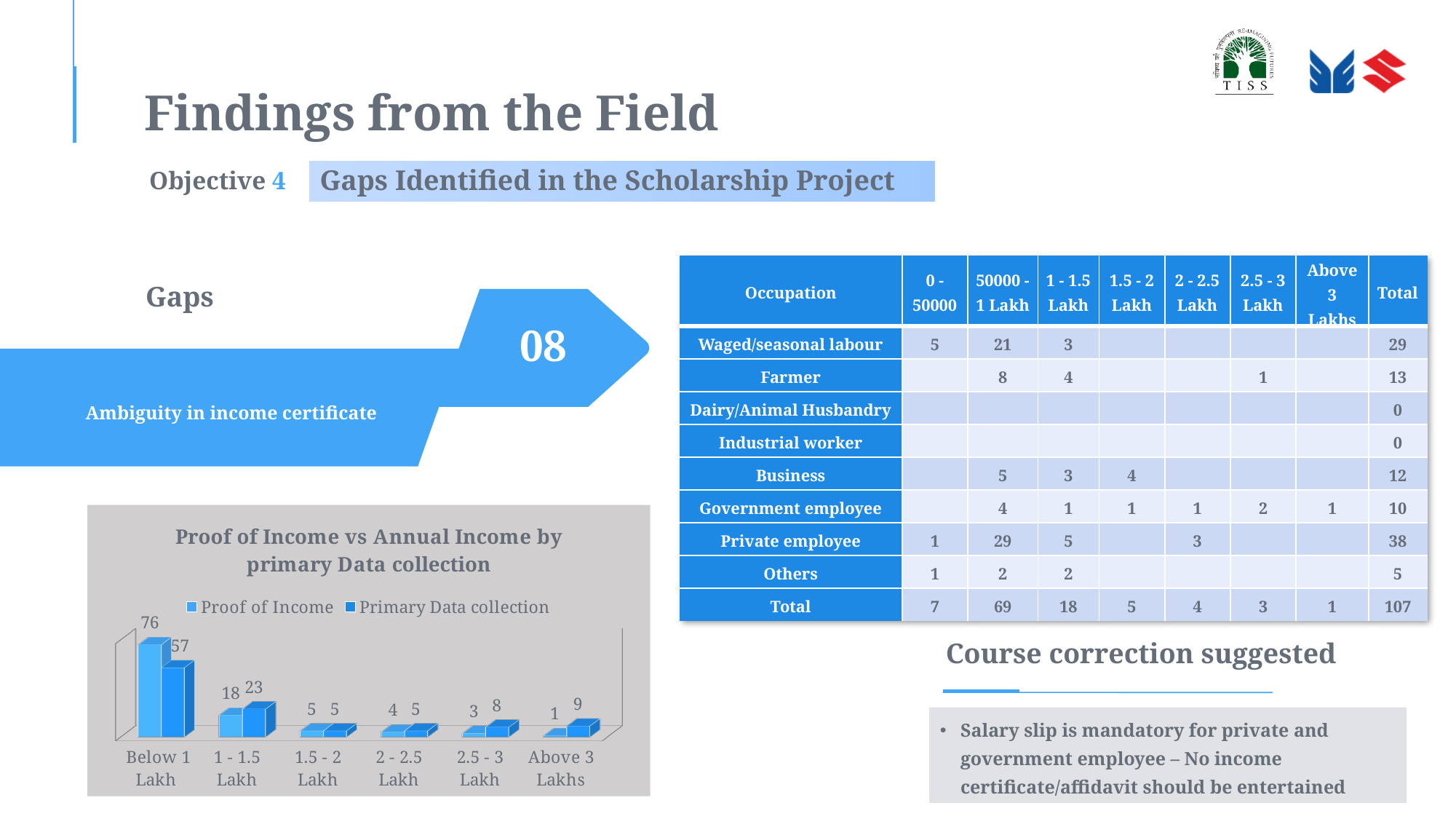
What is the Primary Data collection value for Above 3 Lakhs? 9 Do the Proof of Income values generally rise or fall from Below 1 Lakh to Above 3 Lakhs? fall Which income category has the highest Proof of Income value? Below 1 Lakh What is the Proof of Income value for Below 1 Lakh? 76 How many series does the chart's legend list? 2 How many income categories are shown on the x axis of the chart? 6 What is the title of the chart on the slide? Proof of Income vs Annual Income by primary Data collection What is the Primary Data collection value for 1 - 1.5 Lakh? 23 What type of chart is shown on the slide? bar chart Which income category has the lowest Proof of Income value? Above 3 Lakhs For 2.5 - 3 Lakh, which series has the larger value, Proof of Income or Primary Data collection? Primary Data collection What is the difference between the Proof of Income and Primary Data collection values for Below 1 Lakh? 19